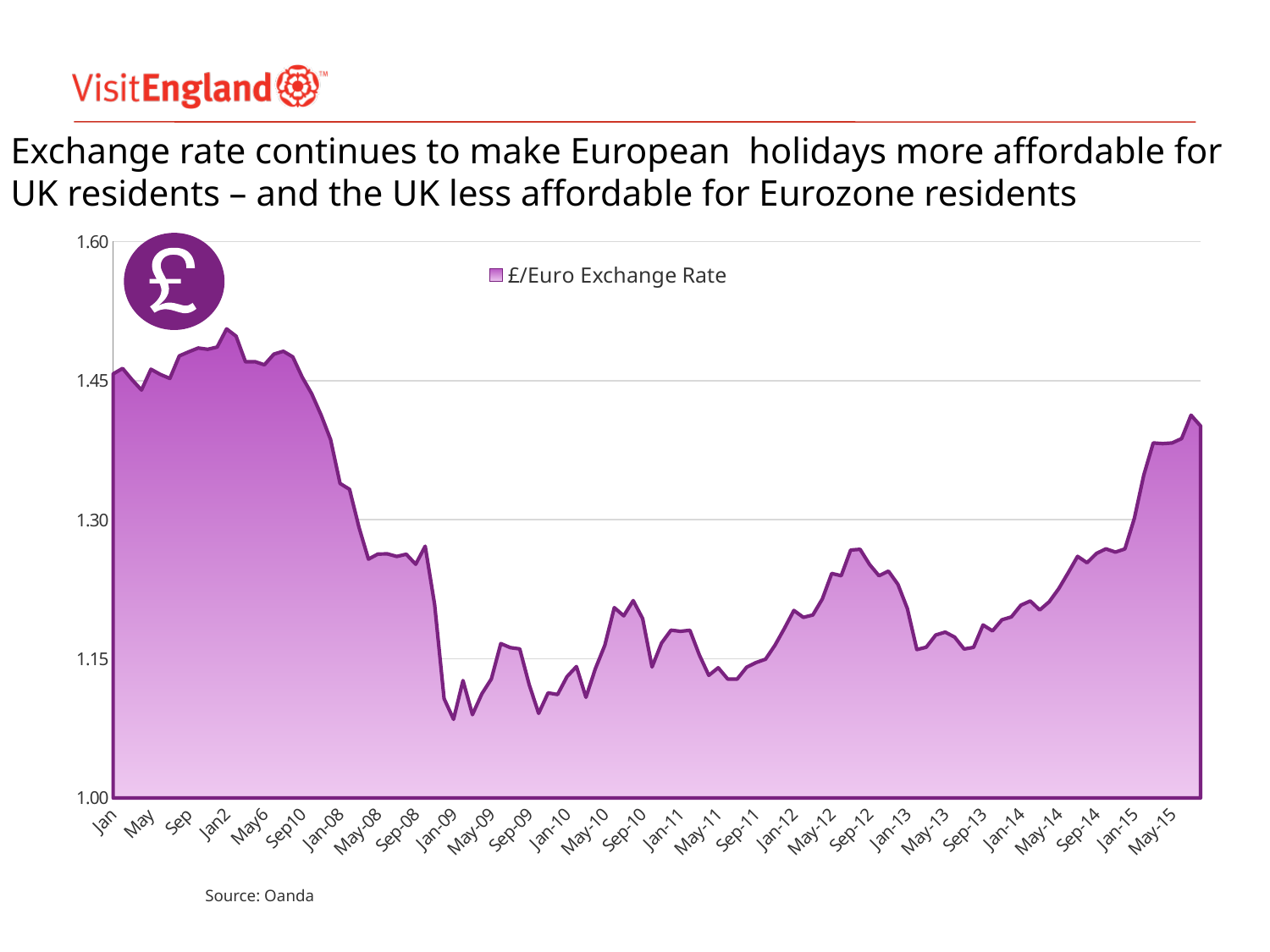
What source is cited for the chart? Oanda What is the name of the series shown in the legend? £/Euro Exchange Rate Is the £/Euro exchange rate at May-15 greater or less than 1.30? greater Is the £/Euro exchange rate at Jan-08 greater or less than 1.30? greater Is the £/Euro exchange rate at Jan-09 greater or less than 1.15? less Near which x-axis label does the £/Euro exchange rate reach its lowest point? Jan-09 What kind of chart is shown on the slide? Area chart Does the £/Euro exchange rate rise or fall between Jan-15 and May-15? rise How many series does the legend list? 1 Which is larger, the £/Euro exchange rate at Jan-08 or at Jan-09? Jan-08 Does the £/Euro exchange rate rise or fall between Jan-08 and Jan-09? fall